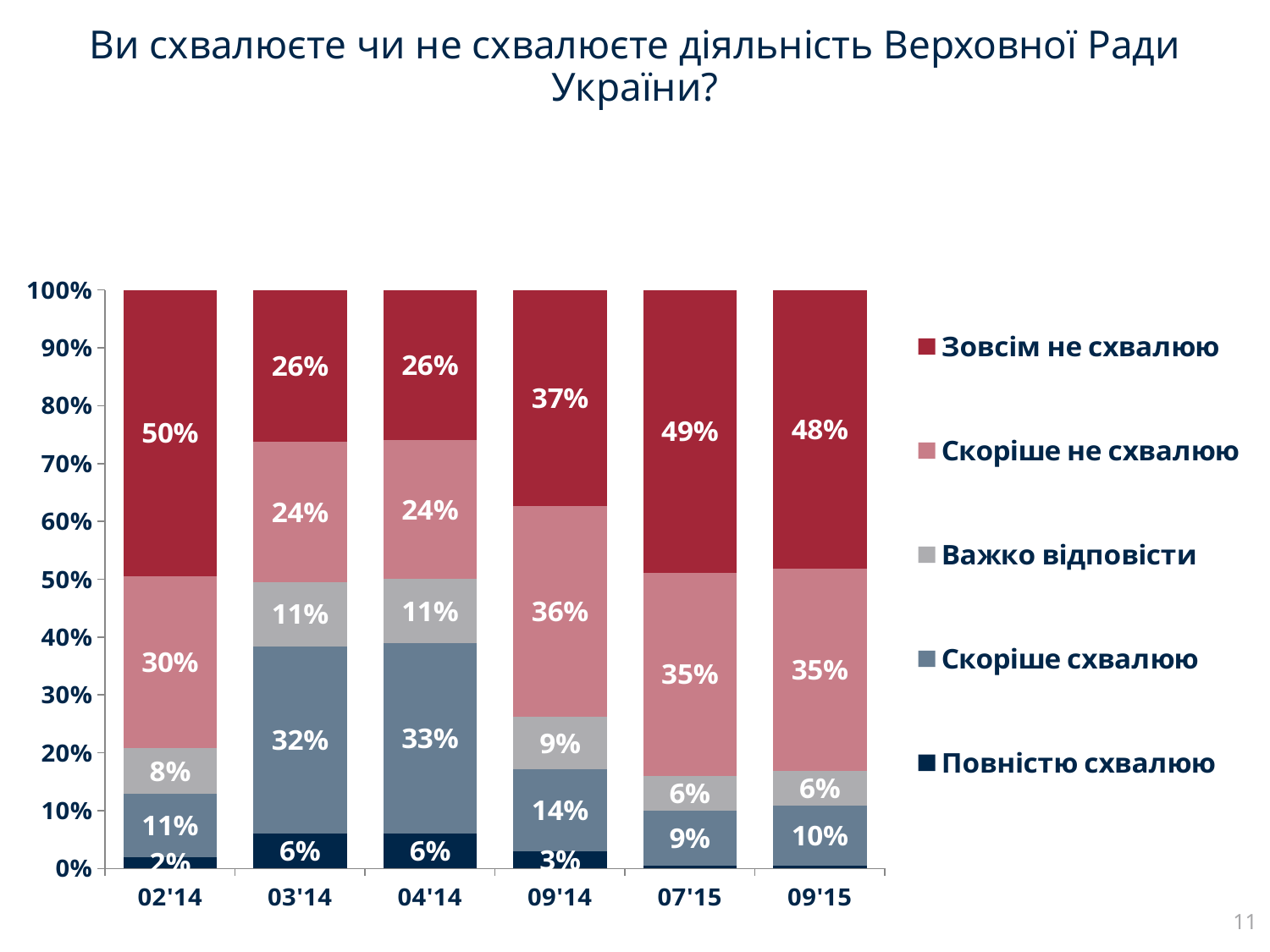
What is the difference between the "Зовсім не схвалюю" values in 07'15 and 09'14? 12% What type of chart is shown on the slide? stacked bar chart What is the value for "Скоріше не схвалюю" in 09'15? 35% How many series does the legend list? 5 In which period is the "Скоріше схвалюю" share the highest? 04'14 What is the value for "Важко відповісти" in 09'14? 9% Which is larger: "Скоріше схвалюю" in 03'14 or "Скоріше не схвалюю" in 03'14? Скоріше схвалюю In which period is the "Зовсім не схвалюю" share the lowest? 03'14 and 04'14 What is the value for "Зовсім не схвалюю" in 02'14? 50% What is the value for "Скоріше схвалюю" in 04'14? 33% How many time periods are shown on the x axis? 6 What is the title of the chart? Ви схвалюєте чи не схвалюєте діяльність Верховної Ради України?